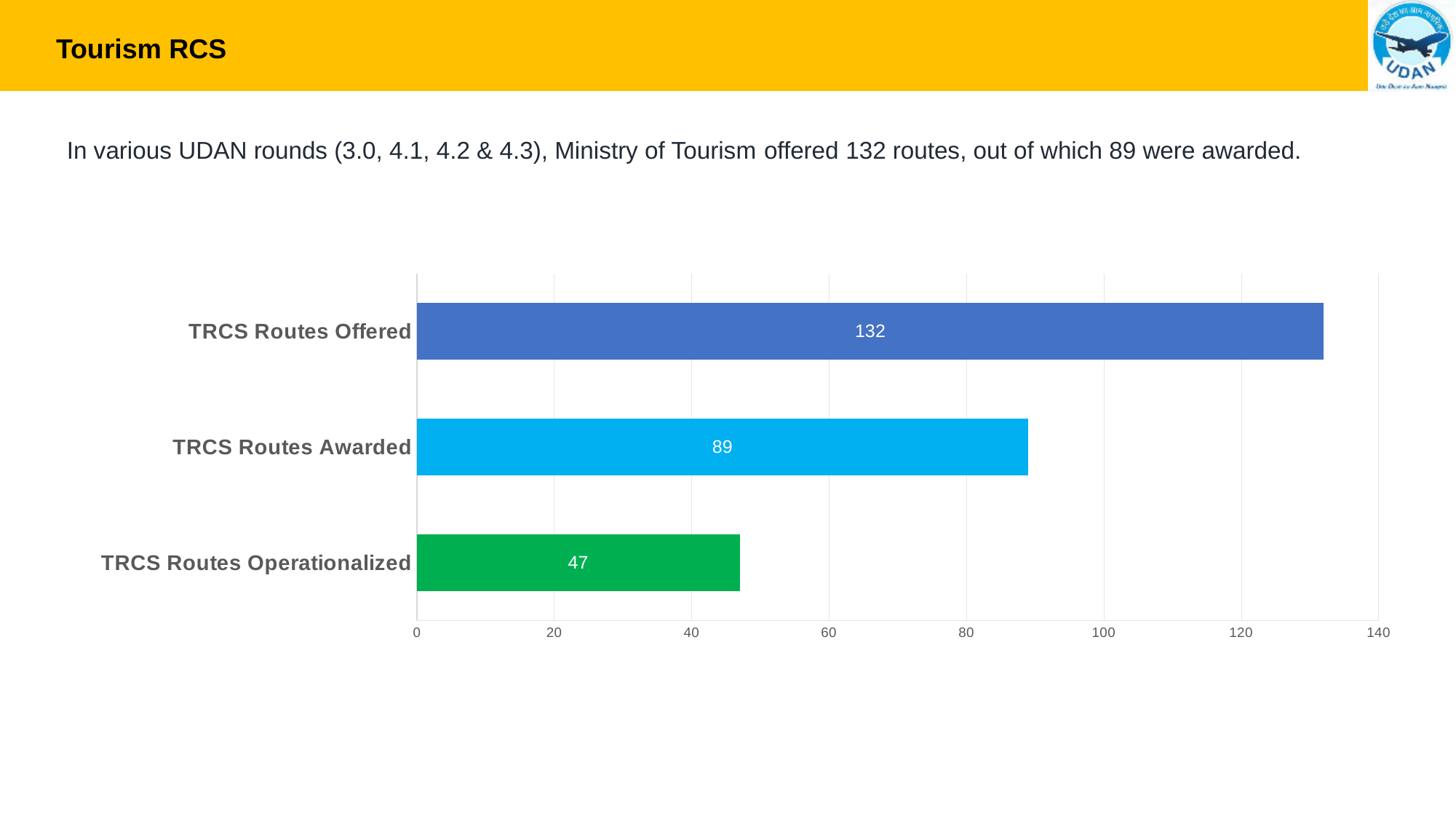
How many categories are shown in the chart? 3 What is the difference between TRCS Routes Awarded and TRCS Routes Operationalized? 42 What is the value for TRCS Routes Operationalized? 47 What is the difference between TRCS Routes Offered and TRCS Routes Awarded? 43 What is the value for TRCS Routes Offered? 132 What is the value for TRCS Routes Awarded? 89 What colour is the bar for TRCS Routes Operationalized? green What kind of chart is shown on the slide? bar chart Which category has the lowest value? TRCS Routes Operationalized Which is larger, TRCS Routes Awarded or TRCS Routes Operationalized? TRCS Routes Awarded Is the value for TRCS Routes Awarded greater or less than 100? less Which category has the highest value? TRCS Routes Offered